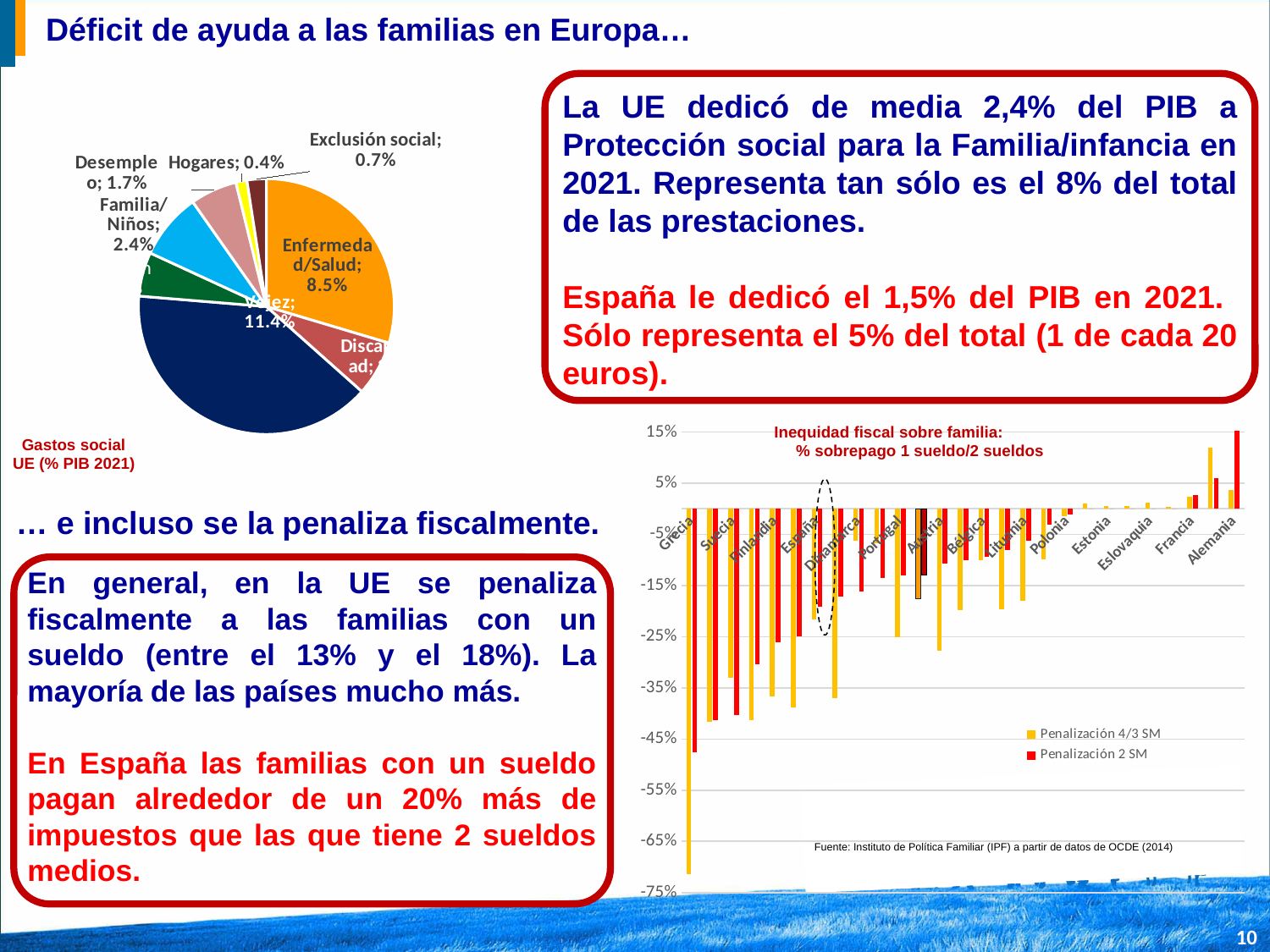
On the chart 'Inequidad fiscal sobre familia', what are the two series named in the legend? Penalización 4/3 SM and Penalización 2 SM On the pie chart 'Gastos social UE (% PIB 2021)', what is the value for Familia/Niños? 2.4% How many series does the legend of the chart 'Inequidad fiscal sobre familia' list? 2 What kind of chart is the chart titled 'Inequidad fiscal sobre familia: % sobrepago 1 sueldo/2 sueldos'? bar chart On the pie chart 'Gastos social UE (% PIB 2021)', what is the value for Hogares? 0.4% On the chart 'Inequidad fiscal sobre familia', is the Penalización 4/3 SM value for Grecia greater or less than -65%? less On the chart 'Inequidad fiscal sobre familia', is the Penalización 2 SM value for Alemania greater or less than 5%? greater On the pie chart 'Gastos social UE (% PIB 2021)', which is larger, Desempleo or Familia/Niños? Familia/Niños On the pie chart 'Gastos social UE (% PIB 2021)', which category has the largest slice? Vejez On the pie chart 'Gastos social UE (% PIB 2021)', what is the difference between Enfermedad/Salud and Familia/Niños? 6.1% On the pie chart 'Gastos social UE (% PIB 2021)', what is the value for Exclusión social? 0.7% On the pie chart 'Gastos social UE (% PIB 2021)', what is the value for Enfermedad/Salud? 8.5%